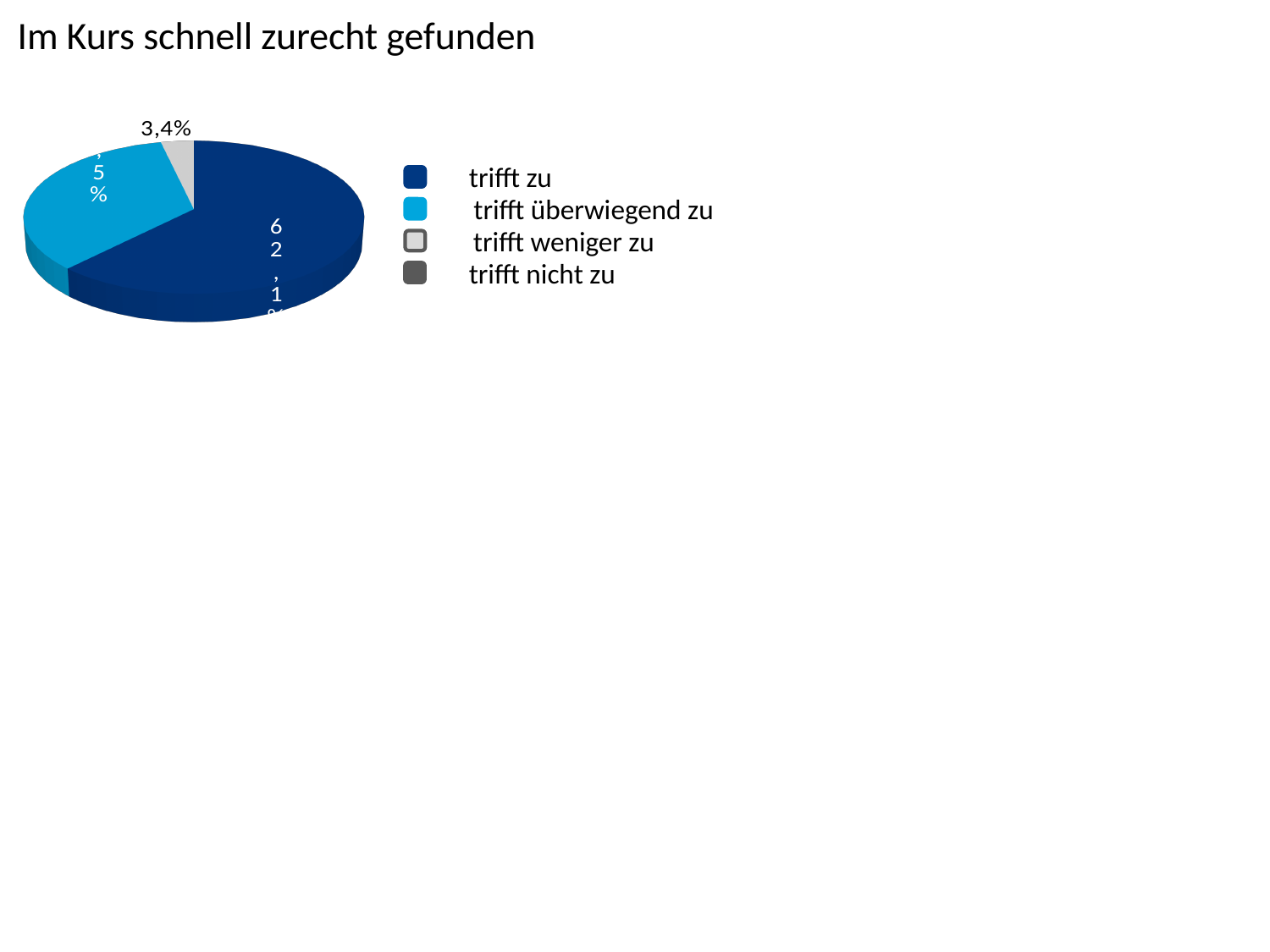
How many slices are visible in the pie chart? 3 What kind of chart is shown on the slide? pie chart How many entries does the legend of the pie chart list? 4 Which slice is larger, 'trifft überwiegend zu' or 'trifft weniger zu'? trifft überwiegend zu Which slice is larger, 'trifft zu' or 'trifft überwiegend zu'? trifft zu Is the share of 'trifft zu' greater or less than 50% of the pie? greater Which category has the largest slice of the pie? trifft zu What is the title of the slide above the pie chart? Im Kurs schnell zurecht gefunden What percentage is shown for the 'trifft zu' slice? 62,1% What colour is the 'trifft zu' slice in the pie chart? dark blue What percentage is shown for the 'trifft weniger zu' slice? 3,4% Which of the visible slices is the smallest? trifft weniger zu